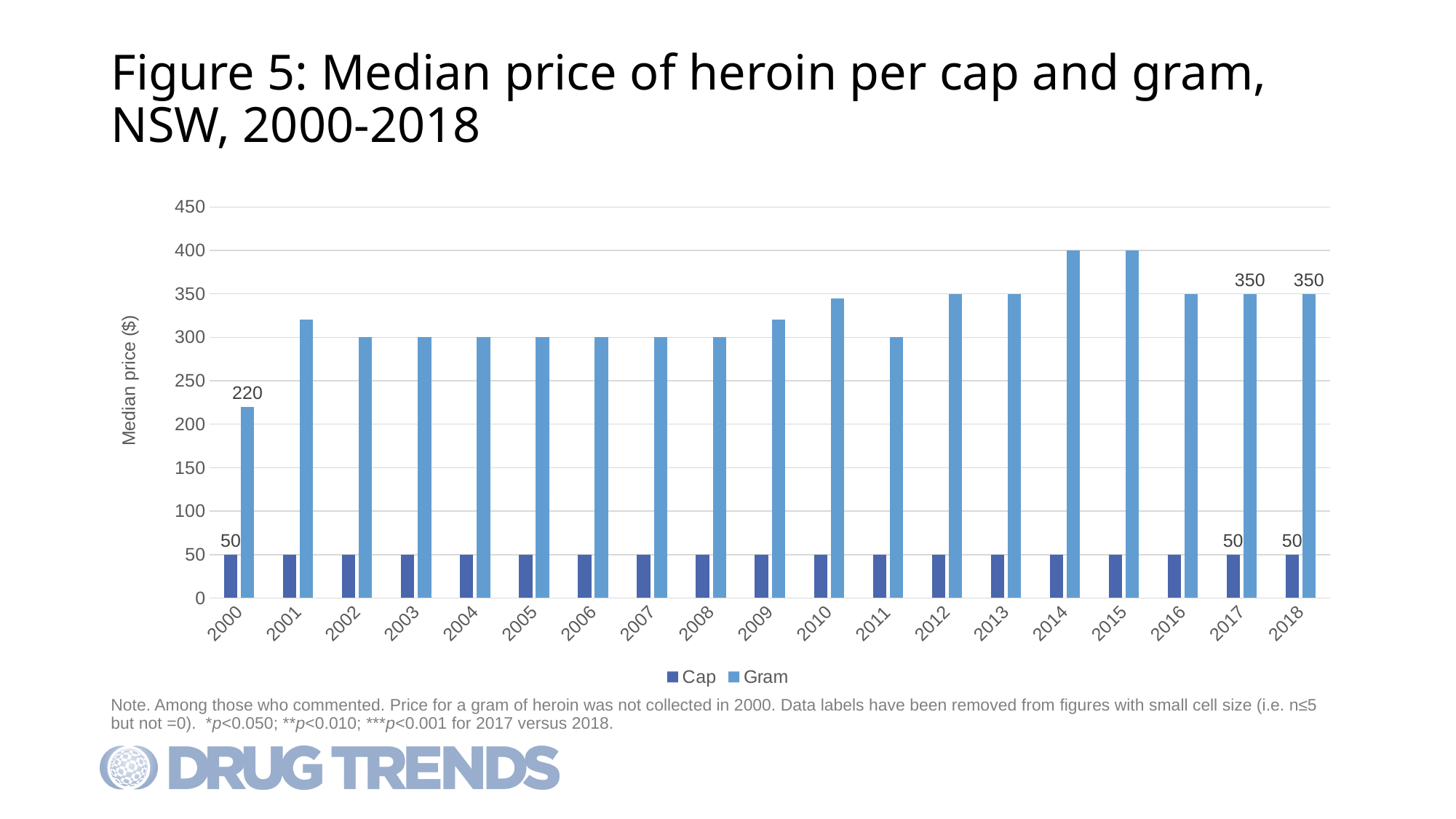
How many series does the legend list? 2 What type of chart is shown on the slide? bar chart Which year has the lowest median price per gram? 2000 Is the median price per gram in 2014 greater or less than 350? greater What is the median price per cap of heroin in 2000? 50 What is the difference between the Gram and Cap median prices in 2018? 300 By how much did the median price per gram increase from 2000 to 2017? 130 Is the median price per gram in 2005 greater or less than 350? less What is the median price per gram of heroin in 2000? 220 What is the median price per gram of heroin in 2017? 350 What is the median price per cap of heroin in 2018? 50 How many years are shown on the x axis? 19